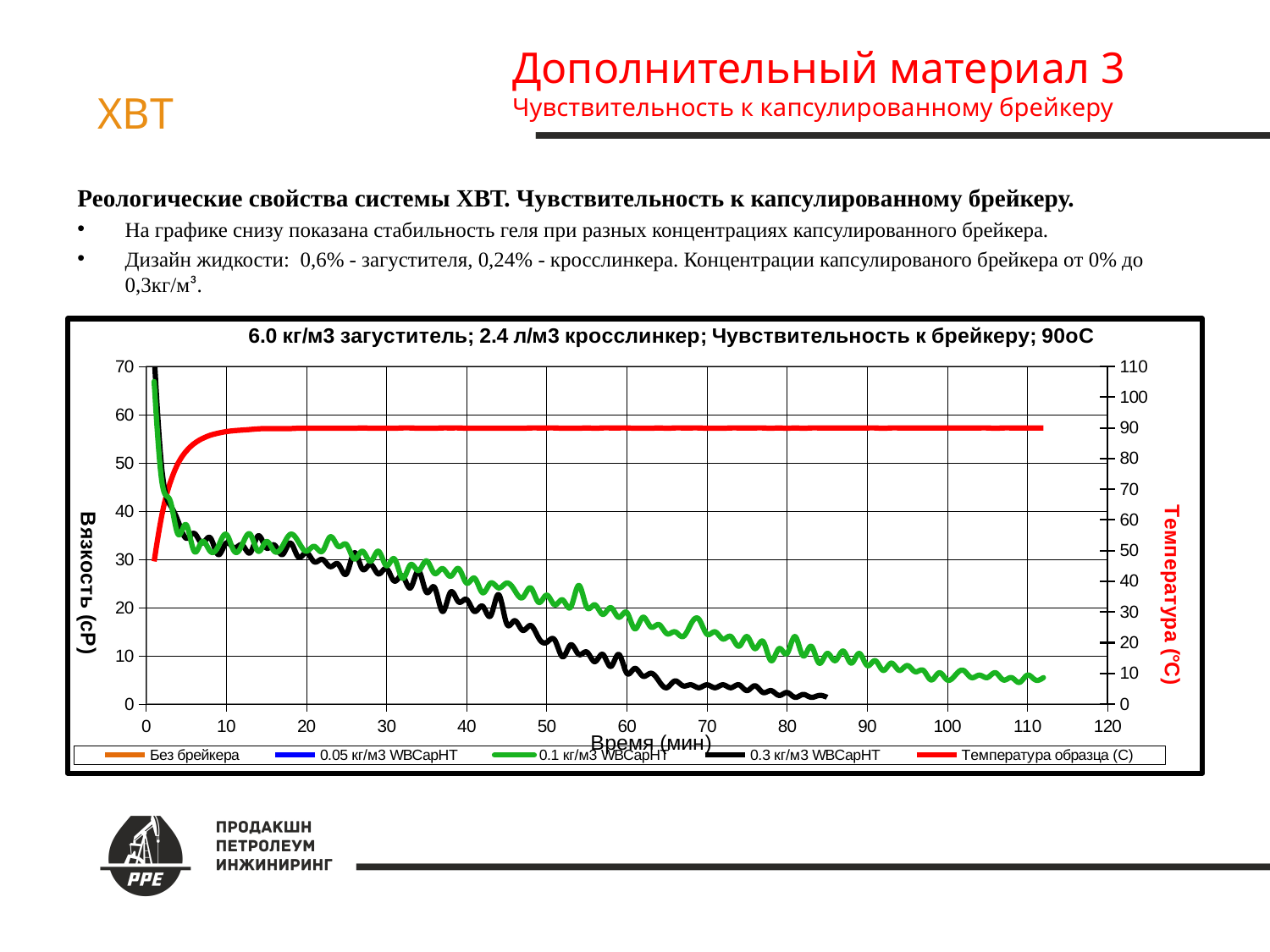
What kind of chart is shown on the slide? line chart Is the viscosity for the 0.3 кг/м3 WBCapHT series at 80 minutes greater or less than 10 cP? less Which series reaches the end of its plotted range at a later time: 0.1 кг/м3 WBCapHT or 0.3 кг/м3 WBCapHT? 0.1 кг/м3 WBCapHT Is the viscosity for the 0.1 кг/м3 WBCapHT series at 20 minutes greater or less than 30 cP? greater At 60 minutes, which series has the higher viscosity: 0.1 кг/м3 WBCapHT or 0.3 кг/м3 WBCapHT? 0.1 кг/м3 WBCapHT What is the label of the left vertical axis of the chart? Вязкость (сР) Is the viscosity for the 0.1 кг/м3 WBCapHT series at 100 minutes greater or less than 10 cP? less Does the viscosity for the 0.1 кг/м3 WBCapHT series rise or fall as time increases? fall What is the title of the chart? 6.0 кг/м3 загуститель; 2.4 л/м3 кросслинкер; Чувствительность к брейкеру; 90оС Does the viscosity for the 0.3 кг/м3 WBCapHT series rise or fall as time increases? fall How many series does the chart legend list? 5